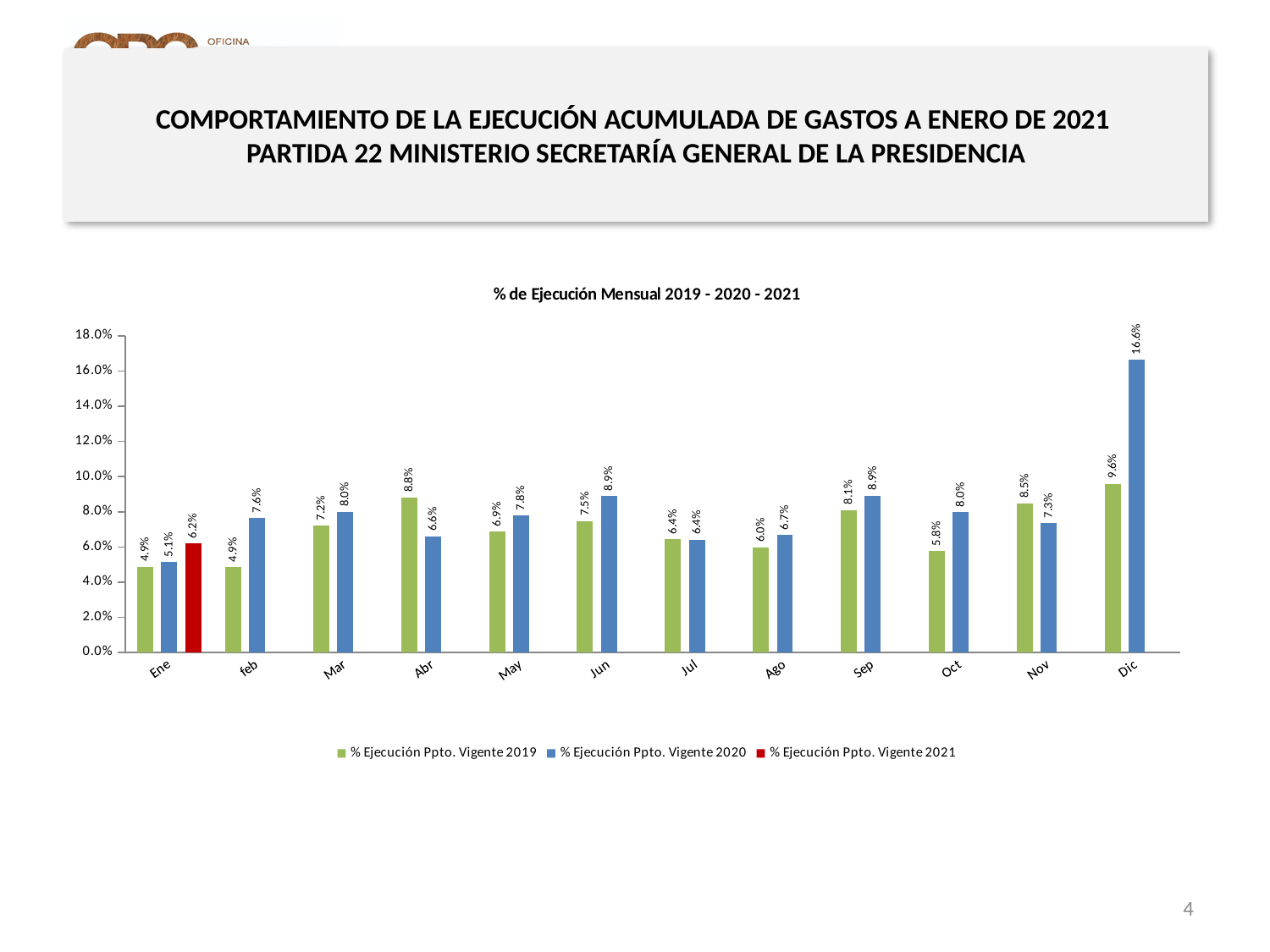
How many series does the legend list? 3 What is the value of % Ejecución Ppto. Vigente 2019 for Abr? 8.8% What kind of chart is shown on the slide? Bar chart What is the value of % Ejecución Ppto. Vigente 2020 for Dic? 16.6% Is the value for % Ejecución Ppto. Vigente 2020 in Dic greater or less than 14.0%? greater What is the difference between the 2020 and 2019 values for Oct? 2.2% Which is larger for Nov: the 2019 value or the 2020 value? 2019 (8.5%) Which month has the highest value for % Ejecución Ppto. Vigente 2020? Dic How many months are shown on the x axis? 12 What is the value of % Ejecución Ppto. Vigente 2021 for Ene? 6.2% What is the title of the chart? % de Ejecución Mensual 2019 - 2020 - 2021 Which month has the lowest value for % Ejecución Ppto. Vigente 2019? Ene and feb (4.9%)